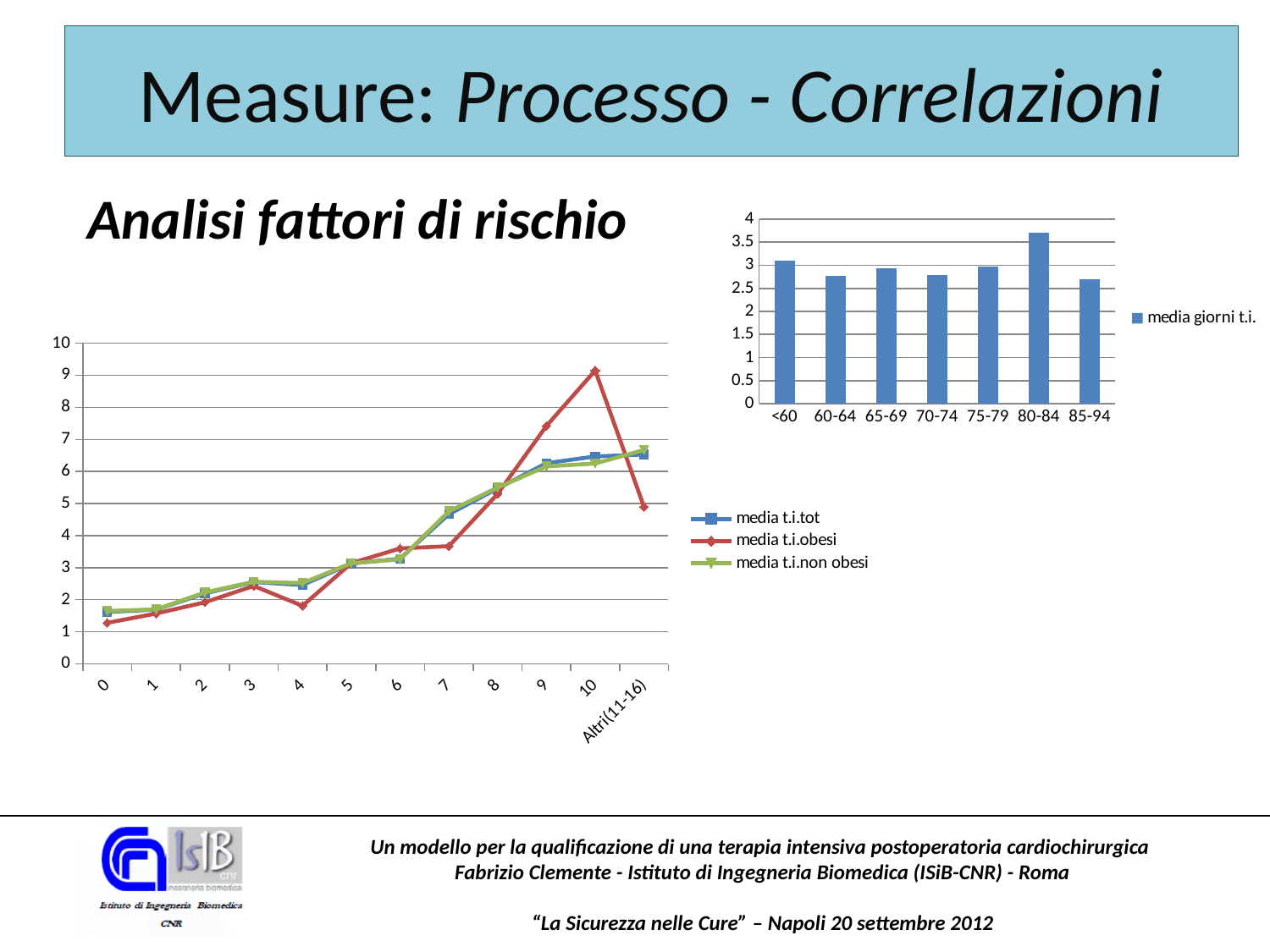
What kind of chart is the chart on the left of the slide? line chart In the bar chart on the right, is the value for 80-84 greater or less than 3.5? greater In the line chart on the left, how many series does the legend list? 3 In the line chart on the left, how many points are on the x axis? 12 In the bar chart on the right, is the value for 85-94 greater or less than 3? less In the bar chart on the right, which age category has the highest value for media giorni t.i.? 80-84 In the line chart on the left, which is larger at x = 10, media t.i.obesi or media t.i.tot? media t.i.obesi In the line chart on the left, is the value of media t.i.obesi at 10 greater or less than 8? greater In the bar chart on the right, how many age categories are shown on the x axis? 7 In the bar chart on the right, what series name does the legend show? media giorni t.i. In the bar chart on the right, which is larger, the value for 80-84 or the value for 60-64? 80-84 What kind of chart is the chart on the right of the slide? bar chart